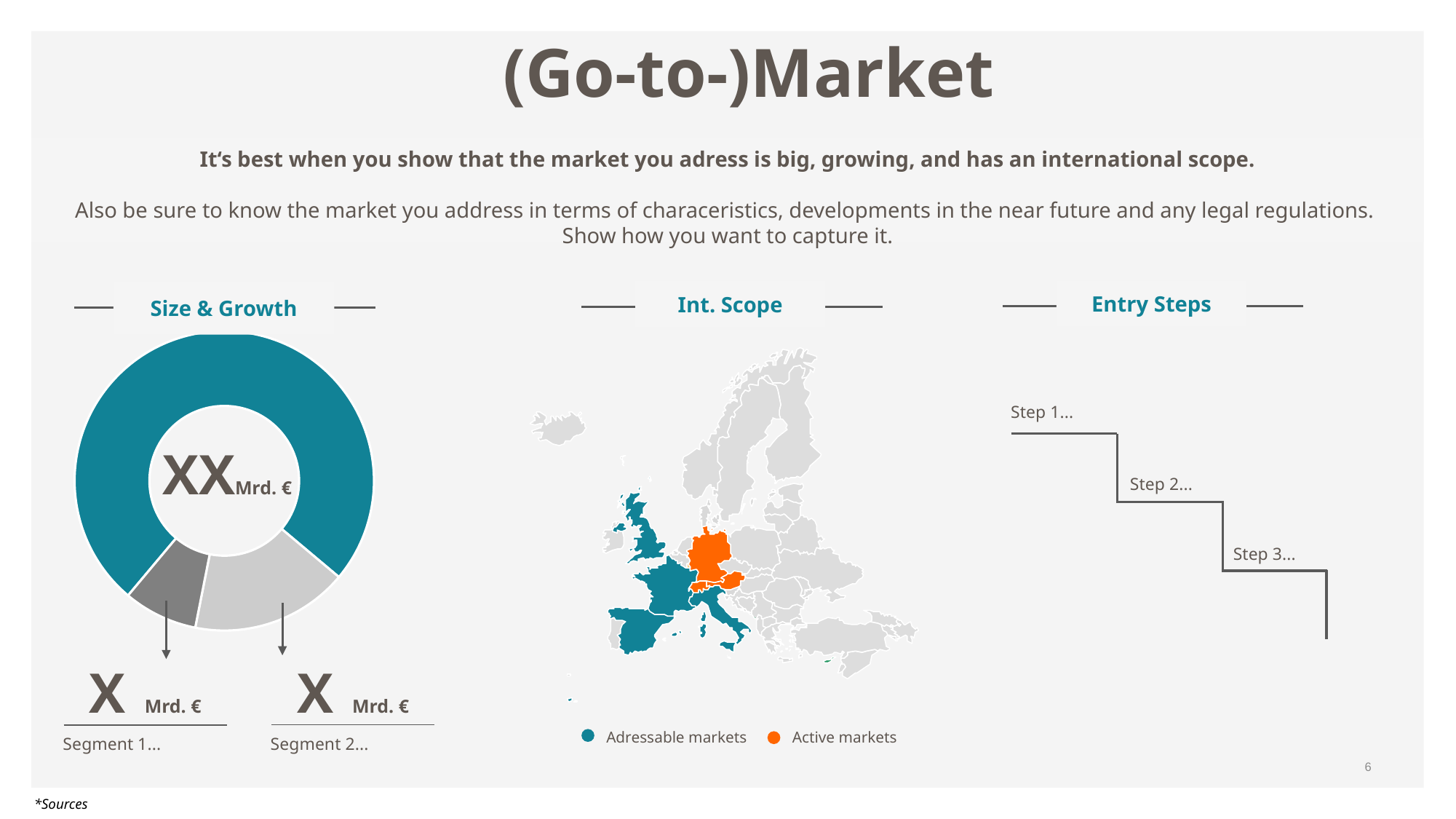
How many slices does the "Size & Growth" donut chart have? 3 What kind of chart is shown under the "Size & Growth" heading? Donut (pie) chart What text is printed in the centre of the "Size & Growth" donut chart? XX Mrd. € What colour is the Segment 1 slice in the "Size & Growth" donut chart? Dark grey In the "Size & Growth" donut chart, which is larger, the Segment 1 slice or the Segment 2 slice? Segment 2 How many entries does the legend below the "Int. Scope" map list? 2 In the "Size & Growth" donut chart, which labelled segment has the smallest slice? Segment 1